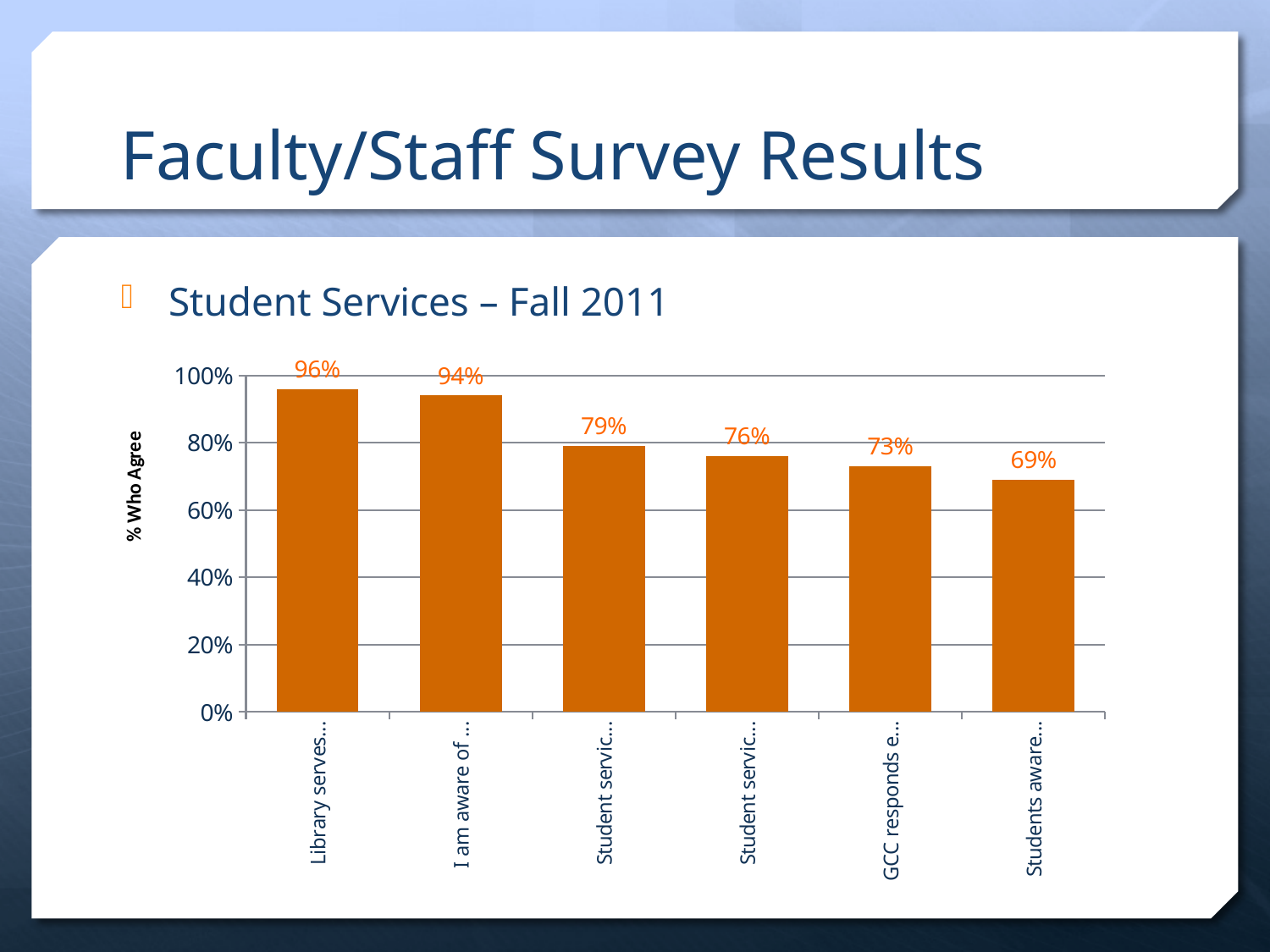
Which is larger, the value for "GCC responds e..." or the value for "Students aware..."? GCC responds e... What is the difference between the values for "Library serves..." and "Students aware..."? 27% What is the value for the bar labelled "I am aware of ..."? 94% What type of chart is shown on the slide? bar chart What is the value for the bar labelled "Library serves..."? 96% What is the value for the bar labelled "GCC responds e..."? 73% How many bars are plotted in the chart? 6 Which category has the lowest value? Students aware... Do the values rise or fall from left to right across the bars? fall Which category has the highest value? Library serves... What is the label on the vertical axis of the chart? % Who Agree What is the value for the bar labelled "Students aware..."? 69%